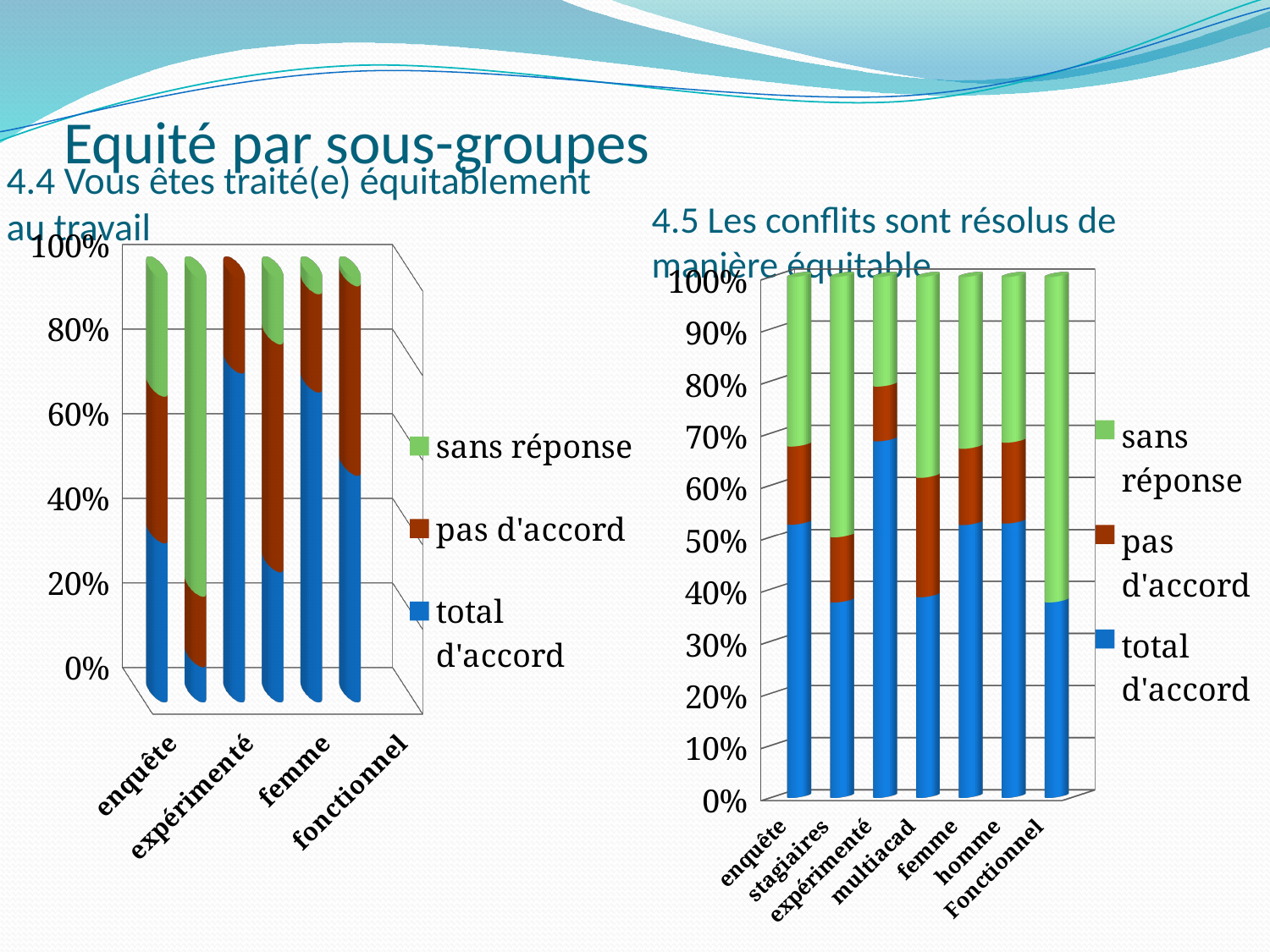
How many bars are plotted in the chart titled '4.4 Vous êtes traité(e) équitablement au travail'? 6 Which colour represents 'sans réponse' in the legend of the chart titled '4.5 Les conflits sont résolus de manière équitable'? green In the chart titled '4.5 Les conflits sont résolus de manière équitable', which category has the largest 'sans réponse' share? Fonctionnel In the chart titled '4.5 Les conflits sont résolus de manière équitable', is the 'total d'accord' value for expérimenté greater or less than 60%? greater What kind of chart is the chart titled '4.5 Les conflits sont résolus de manière équitable'? stacked bar chart In the chart titled '4.5 Les conflits sont résolus de manière équitable', which has a larger 'pas d'accord' share: multiacad or expérimenté? multiacad In the chart titled '4.4 Vous êtes traité(e) équitablement au travail', is the 'total d'accord' value for enquête greater or less than 40%? less In the chart titled '4.5 Les conflits sont résolus de manière équitable', which has a larger 'total d'accord' share: enquête or multiacad? enquête How many series does the legend list in the chart titled '4.4 Vous êtes traité(e) équitablement au travail'? 3 In the chart titled '4.5 Les conflits sont résolus de manière équitable', is the 'total d'accord' value for stagiaires greater or less than 50%? less In the chart titled '4.5 Les conflits sont résolus de manière équitable', which category has the highest 'total d'accord' share? expérimenté How many categories are shown on the x axis of the chart titled '4.5 Les conflits sont résolus de manière équitable'? 7